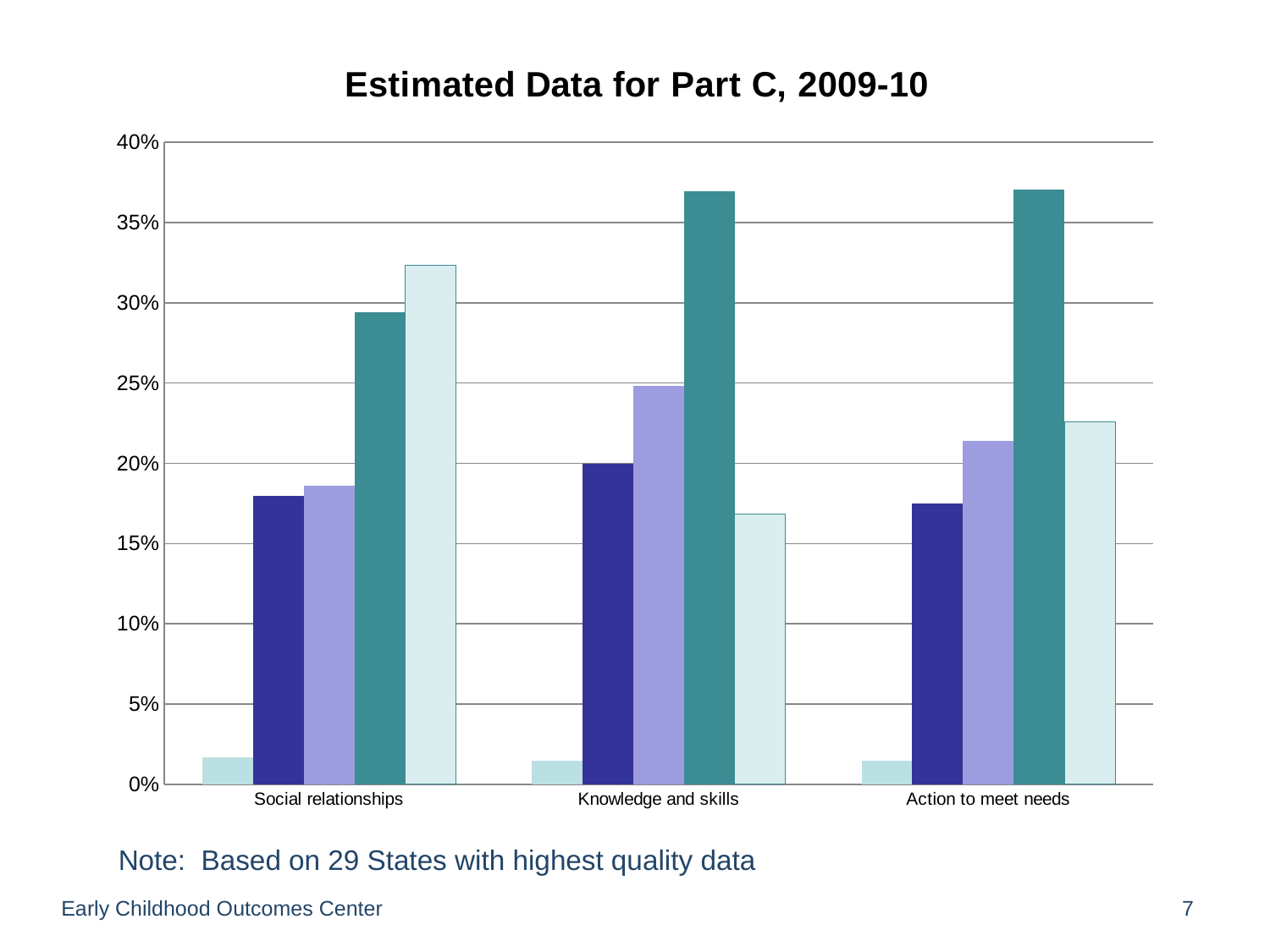
What is the maximum value shown on the y axis? 40% Is the value of the dark blue bar in the Social relationships group greater or less than 20%? less Is the value of the rightmost (pale) bar in the Knowledge and skills group greater or less than 20%? less In the Social relationships group, which is larger: the dark teal bar or the pale rightmost bar? the pale rightmost bar Which bar is the lowest in the Action to meet needs group? the leftmost light teal bar What is the title of the chart? Estimated Data for Part C, 2009-10 How many bars are plotted for each category? 5 In the Knowledge and skills group, which is larger: the dark teal bar or the pale rightmost bar? the dark teal bar Is the value of the tallest bar in the Social relationships group greater or less than 30%? greater How many categories are shown on the x axis? 3 What kind of chart is shown on the slide? bar chart